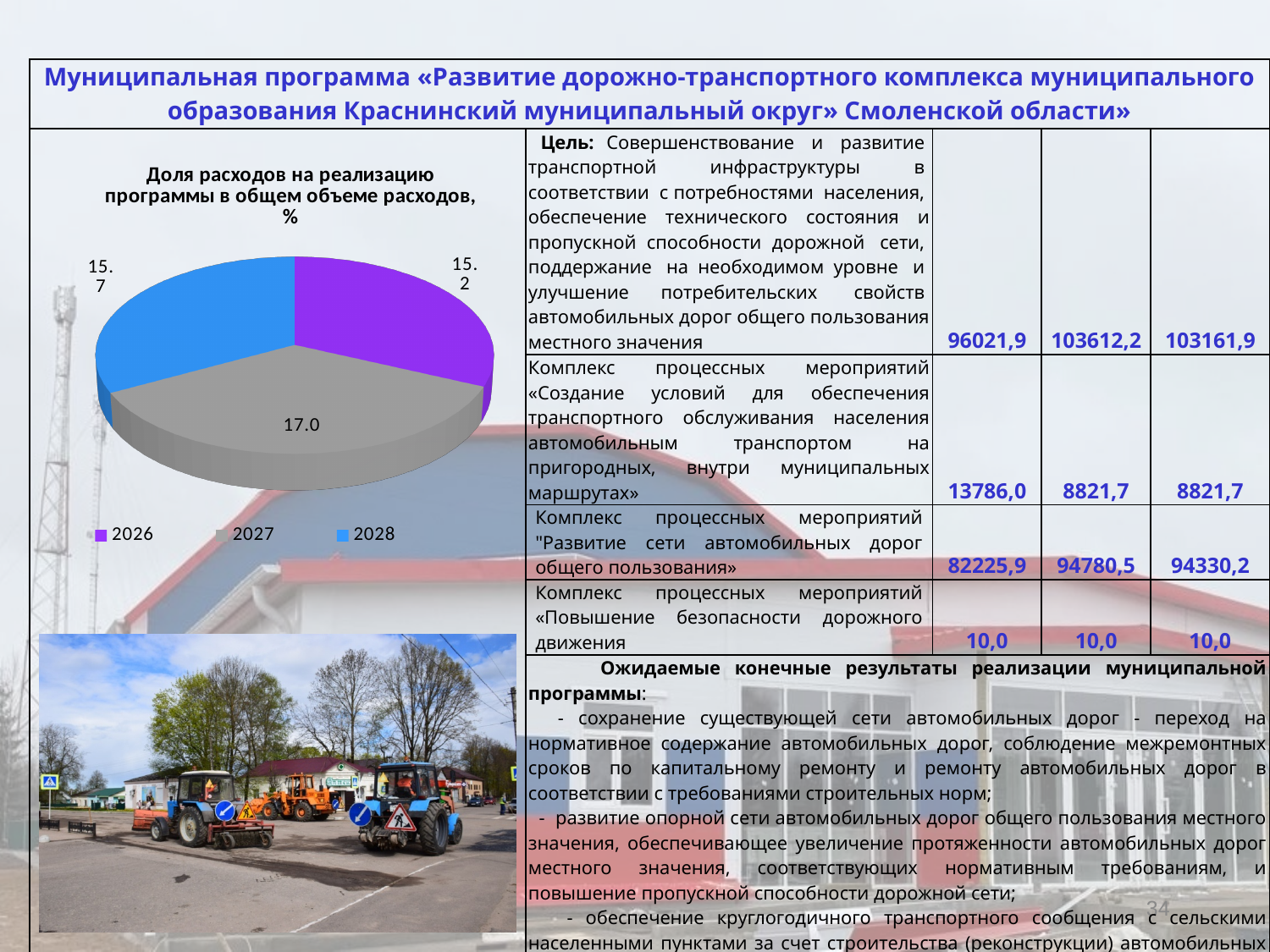
What is the value for 2026 in the pie chart? 15.2 What is the difference between the values for 2027 and 2026 in the pie chart? 1.8 How many slices does the pie chart have? 3 Which year has the lowest value in the pie chart? 2026 What is the value for 2027 in the pie chart? 17.0 What is the difference between the values for 2028 and 2026 in the pie chart? 0.5 What colour is the slice for 2027 in the pie chart? gray What is the value for 2028 in the pie chart? 15.7 Which year has the highest value in the pie chart? 2027 What kind of chart is shown on the slide? pie chart Which is larger in the pie chart, the value for 2027 or the value for 2028? 2027 How many entries does the legend of the pie chart list? 3